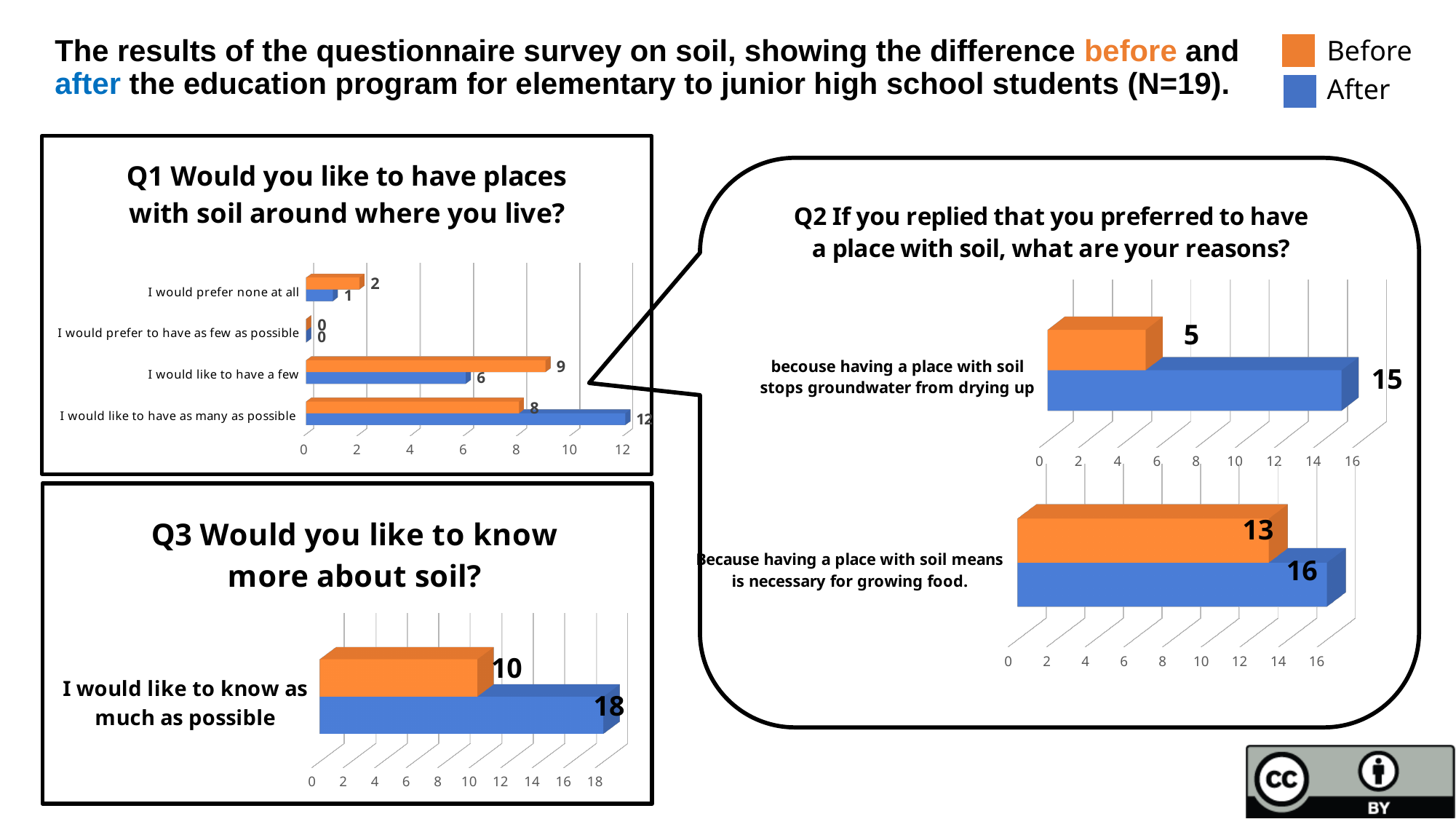
In the Q2 chart, what is the Before value for "Because having a place with soil means is necessary for growing food."? 13 In the Q1 chart, which category has the highest After value? I would like to have as many as possible In the Q1 chart, what is the Before value for "I would like to have a few"? 9 In the Q1 chart, what is the difference between the Before and After values for "I would like to have as many as possible"? 4 In the Q3 chart, what is the difference between the After and Before values? 8 In the Q1 chart, what is the After value for "I would like to have as many as possible"? 12 What type of chart is used for Q3? bar chart In the Q2 chart, what is the difference between the After and Before values for "because having a place with soil stops groundwater from drying up"? 10 In the Q1 chart, is the Before value for "I would prefer none at all" larger or smaller than its After value? larger In the Q2 chart, what is the After value for "because having a place with soil stops groundwater from drying up"? 15 In the Q3 chart, what is the After value for "I would like to know as much as possible"? 18 In the Q1 chart, how many response categories are shown? 4